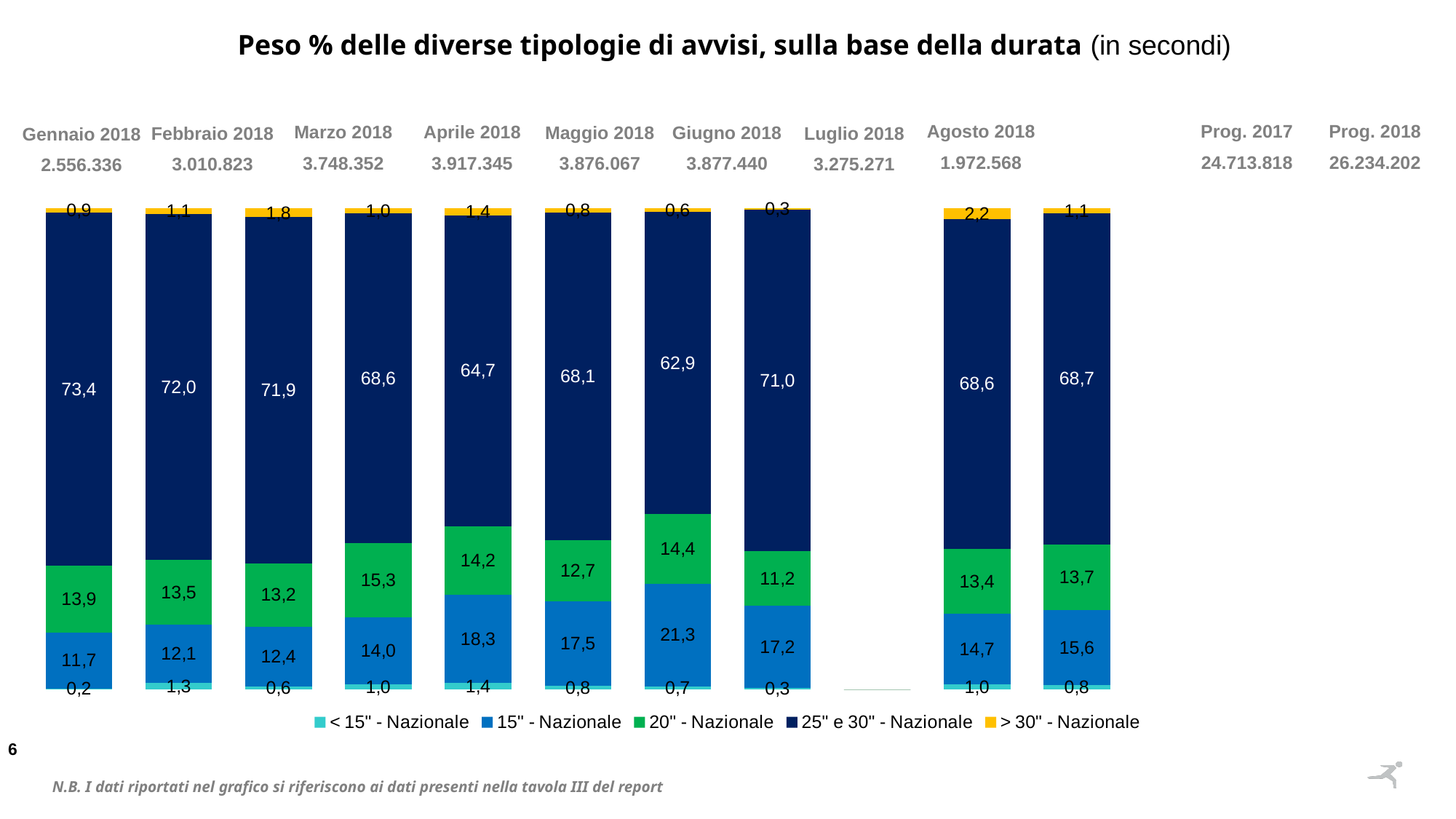
What kind of chart is shown on the slide? stacked bar chart What is the lowest value shown for the 25" e 30" - Nazionale series across all bars? 62,9 What is the value of the 15" - Nazionale segment in the first bar (Gennaio 2018)? 11,7 What is the title of the chart? Peso % delle diverse tipologie di avvisi, sulla base della durata (in secondi) In the first bar (Gennaio 2018), what is the difference between the 25" e 30" - Nazionale value and the 15" - Nazionale value? 61,7 What is the highest value shown for the 15" - Nazionale series across all bars? 21,3 What is the value of the 25" e 30" - Nazionale segment in the first bar (Gennaio 2018)? 73,4 In the first bar (Gennaio 2018), which is larger: the 20" - Nazionale segment or the 15" - Nazionale segment? 20" - Nazionale What colour represents the > 30" - Nazionale series in the legend? yellow What is the highest value shown for the 25" e 30" - Nazionale series across all bars? 73,4 How many series does the legend list? 5 What is the value of the 20" - Nazionale segment in the second bar (Febbraio 2018)? 13,5